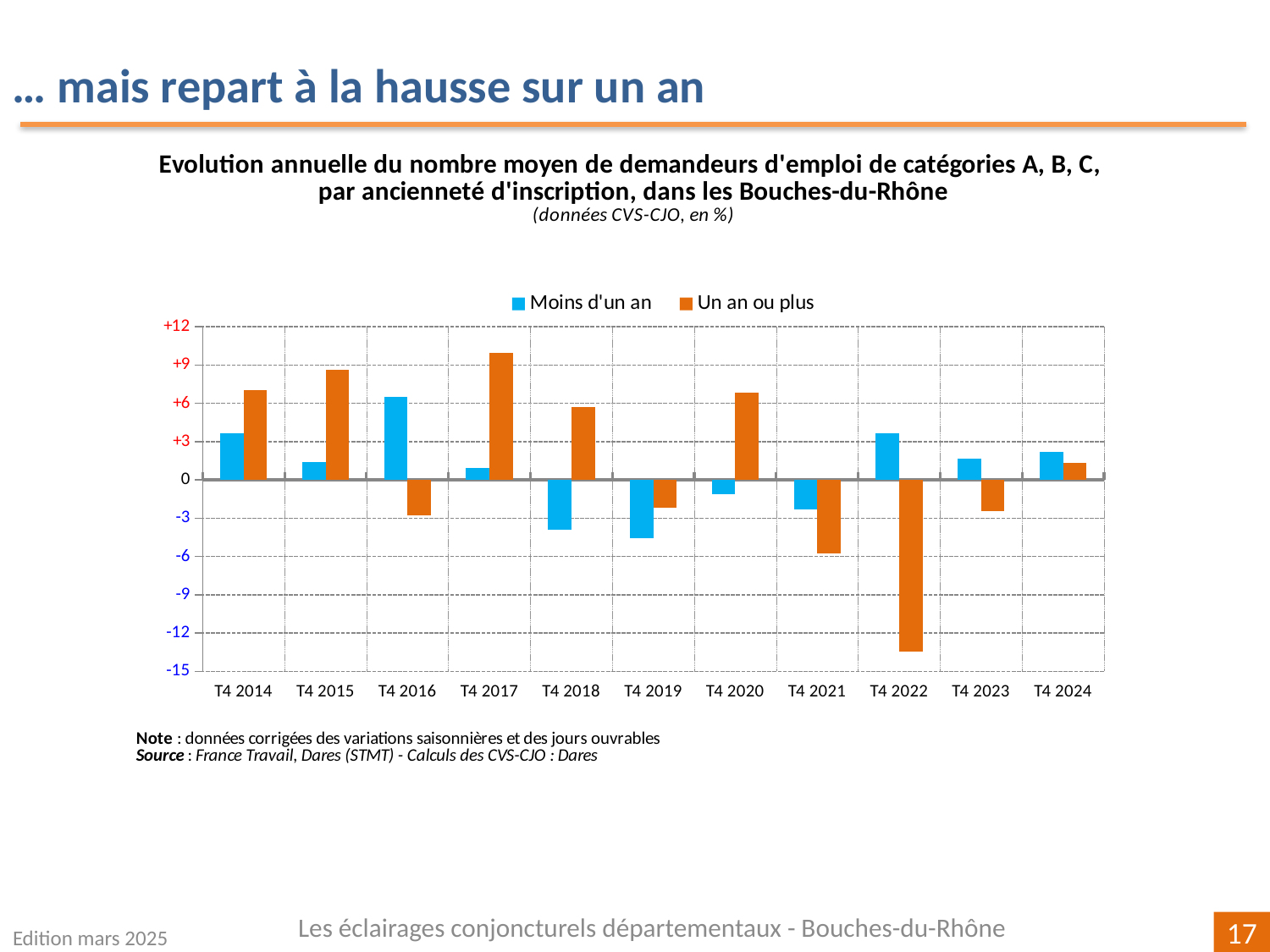
In which quarter is the value for 'Un an ou plus' the lowest? T4 2022 In which quarter is the value for 'Un an ou plus' the highest? T4 2017 What kind of chart is shown on the slide? Bar chart In which quarter is the value for 'Moins d'un an' the highest? T4 2016 In T4 2018, which series has the larger value, 'Moins d'un an' or 'Un an ou plus'? Un an ou plus In which quarter is the value for 'Moins d'un an' the lowest? T4 2019 What colour represents the 'Moins d'un an' series? Blue In T4 2024, which series has the larger value, 'Moins d'un an' or 'Un an ou plus'? Moins d'un an Is the value for 'Un an ou plus' in T4 2017 greater or less than +9? greater How many series does the legend list? 2 How many quarters (categories) are shown on the x axis? 11 Is the value for 'Un an ou plus' in T4 2022 greater or less than -12? less